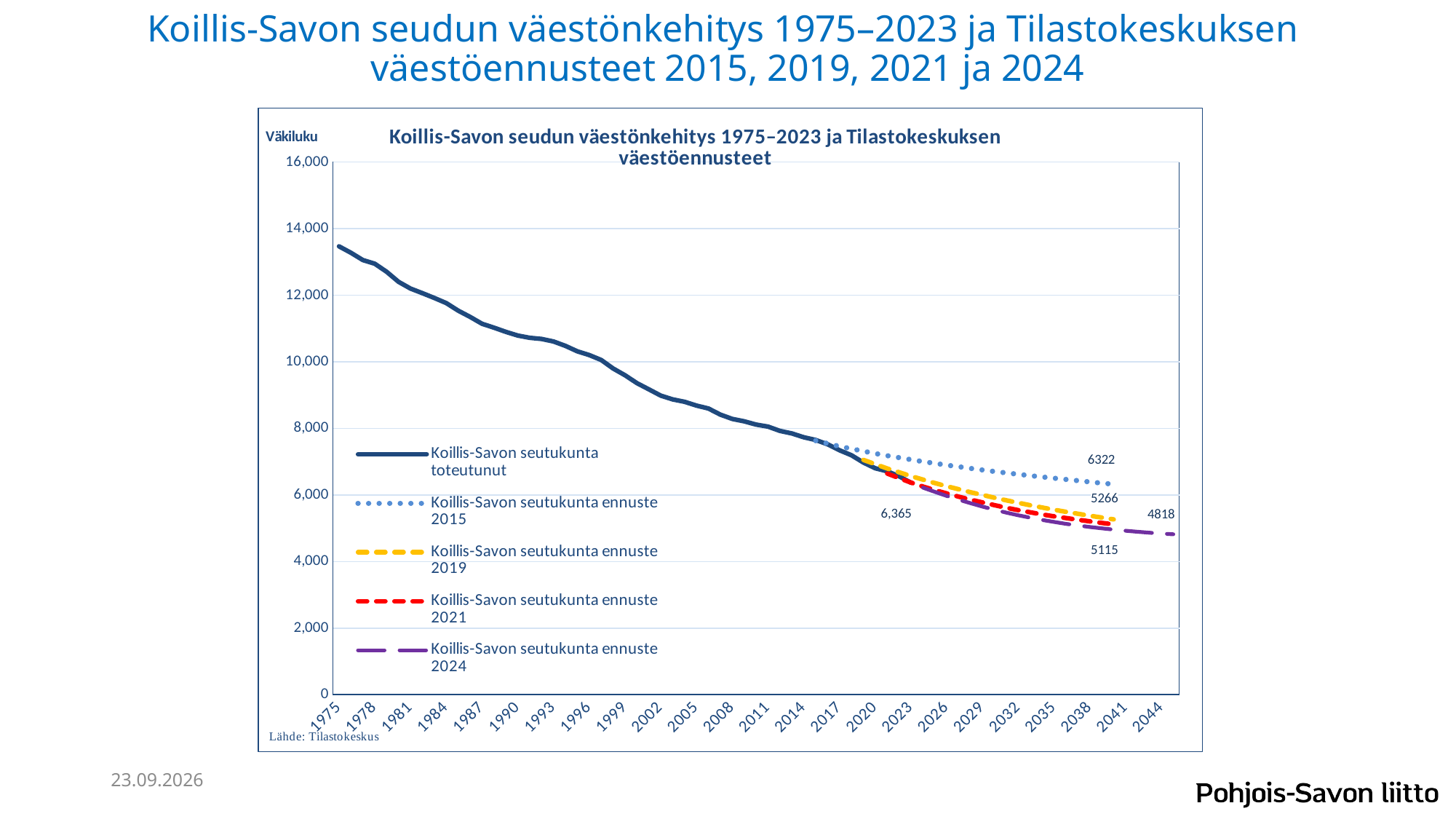
What kind of chart is shown on the slide? line chart Which forecast line ends at the highest labelled value? Koillis-Savon seutukunta ennuste 2015 What is the final labelled value of the 2021 forecast (ennuste 2021) line? 5115 Which forecast line ends at the lowest labelled value? Koillis-Savon seutukunta ennuste 2024 What is the final labelled value of the 2024 forecast (ennuste 2024) line? 4818 What is the label on the vertical axis of the chart? Väkiluku How many series does the legend list? 5 What is the final labelled value of the 2019 forecast (ennuste 2019) line? 5266 What is the final labelled value of the 2015 forecast (ennuste 2015) line? 6322 What is the difference between the final labelled values of the 2015 forecast (6322) and the 2019 forecast (5266)? 1056 Is the realised population value for 1975 greater or less than 12,000? greater Does the realised population (Koillis-Savon seutukunta toteutunut) rise or fall from 1975 to 2023? fall